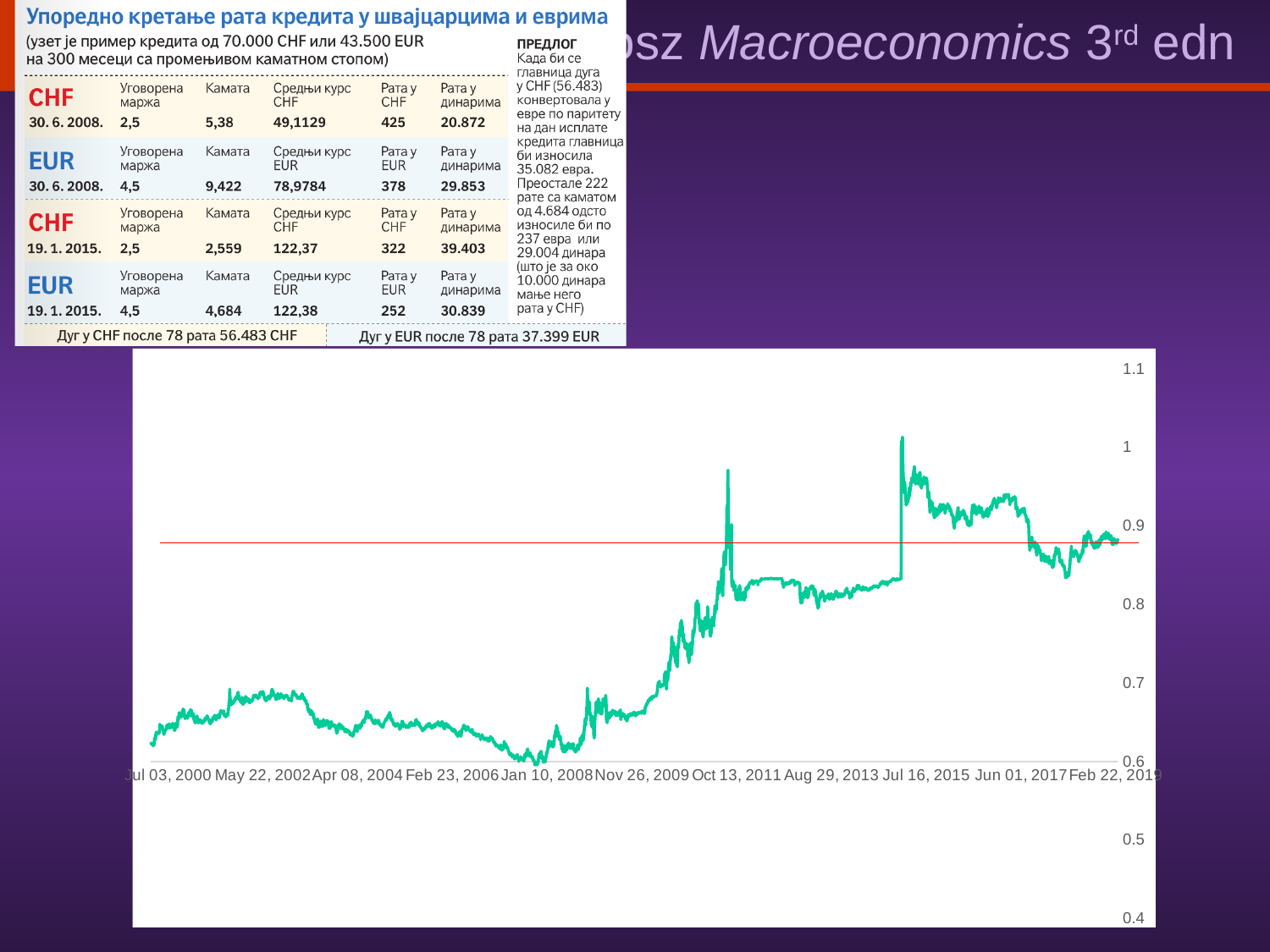
Is the value of the line at Oct 13, 2011 greater or less than 0.7? greater What is the last date label on the x axis of the line chart? Feb 22, 2019 Is the value of the line at Feb 23, 2006 greater or less than 0.7? less What is the first date label on the x axis of the line chart? Jul 03, 2000 Is the value of the line at Jul 16, 2015 greater or less than 0.9? greater What kind of chart is shown in the lower part of the slide? line chart How many date labels are shown along the x axis of the line chart? 11 Is the value of the line higher at Jul 16, 2015 or at Jul 03, 2000? Jul 16, 2015 Overall, does the line rise or fall from Jul 03, 2000 to Feb 22, 2019? rise How many lines (data series) are plotted on the line chart? 1 Is the value of the line higher at Jan 10, 2008 or at Aug 29, 2013? Aug 29, 2013